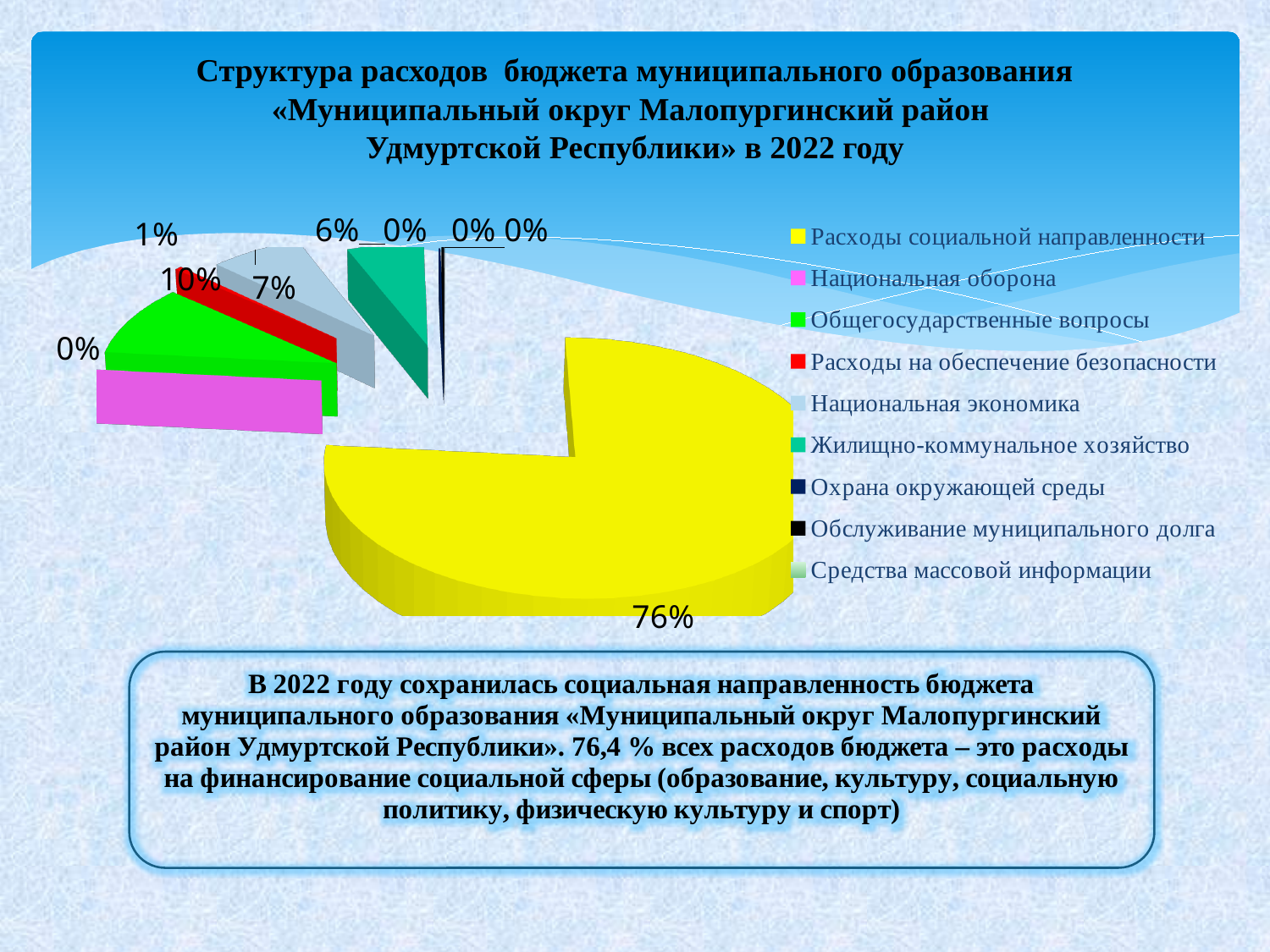
What share of the pie is labelled for «Национальная экономика»? 7% What share of the pie is labelled for «Жилищно-коммунальное хозяйство»? 6% What kind of chart is shown on the slide? pie chart What is the difference between the shares of «Национальная экономика» and «Жилищно-коммунальное хозяйство»? 1% What share of the pie does «Расходы социальной направленности» take? 76% Which is larger: the slice for «Расходы социальной направленности» or the slice for «Национальная экономика»? Расходы социальной направленности How many categories does the legend of the pie chart list? 9 Which year does the chart title say the budget expenditure structure refers to? 2022 What colour is the slice for «Расходы социальной направленности»? yellow Which category has the largest slice of the pie? Расходы социальной направленности